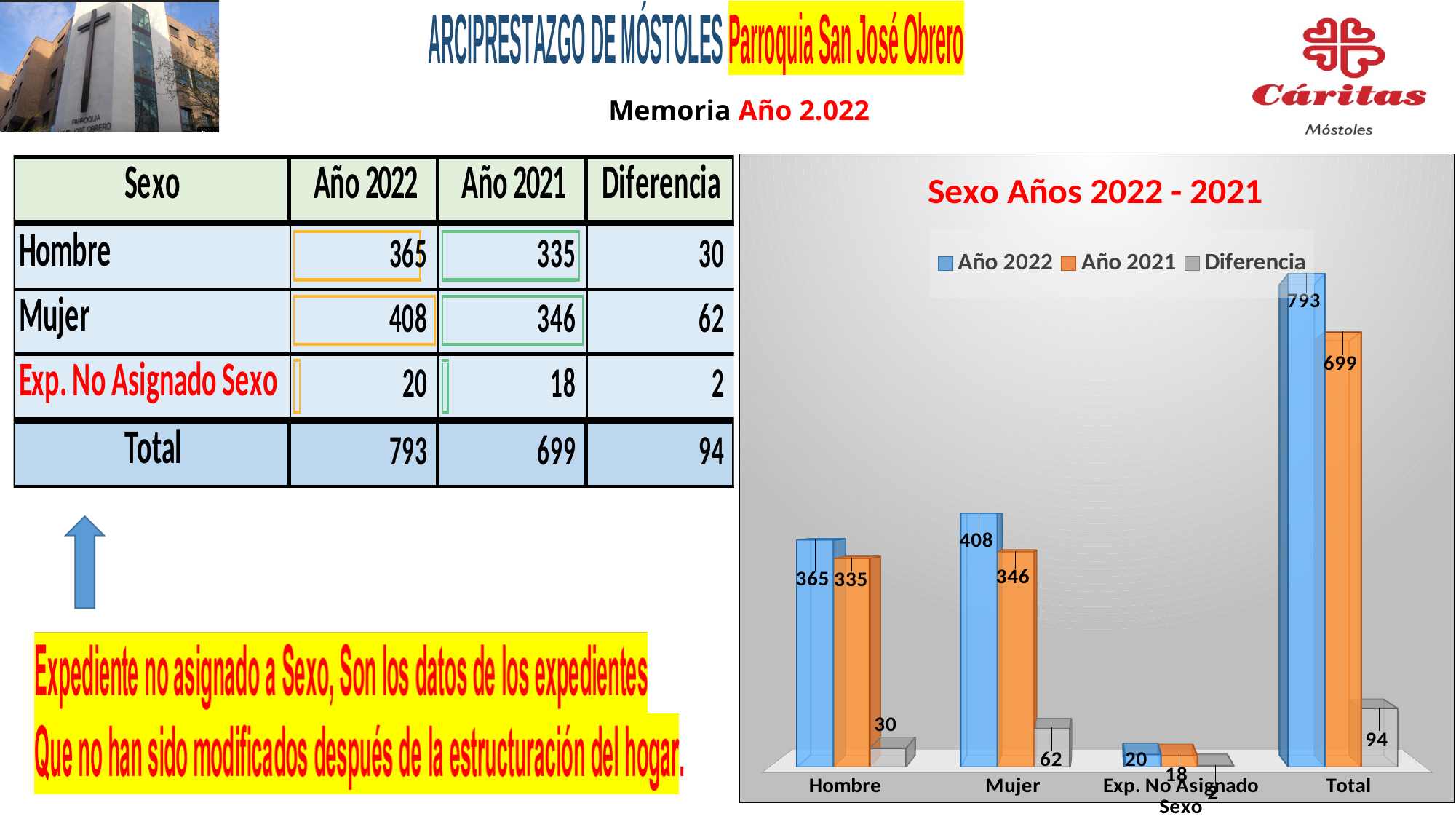
What is the title of the chart? Sexo Años 2022 - 2021 Which category has the highest value in the Año 2022 series? Total What is the value for Total in the Año 2021 series? 699 What is the difference between the Año 2022 and Año 2021 values for Hombre? 30 What kind of chart is shown? bar chart How many series does the legend list? 3 What is the Diferencia value for Mujer? 62 How many categories are shown on the x axis? 4 Which is larger, the Año 2022 value for Mujer or the Año 2022 value for Hombre? Mujer Which category has the lowest value in the Año 2021 series? Exp. No Asignado Sexo What is the value for Hombre in the Año 2021 series? 335 What is the value for Mujer in the Año 2022 series? 408